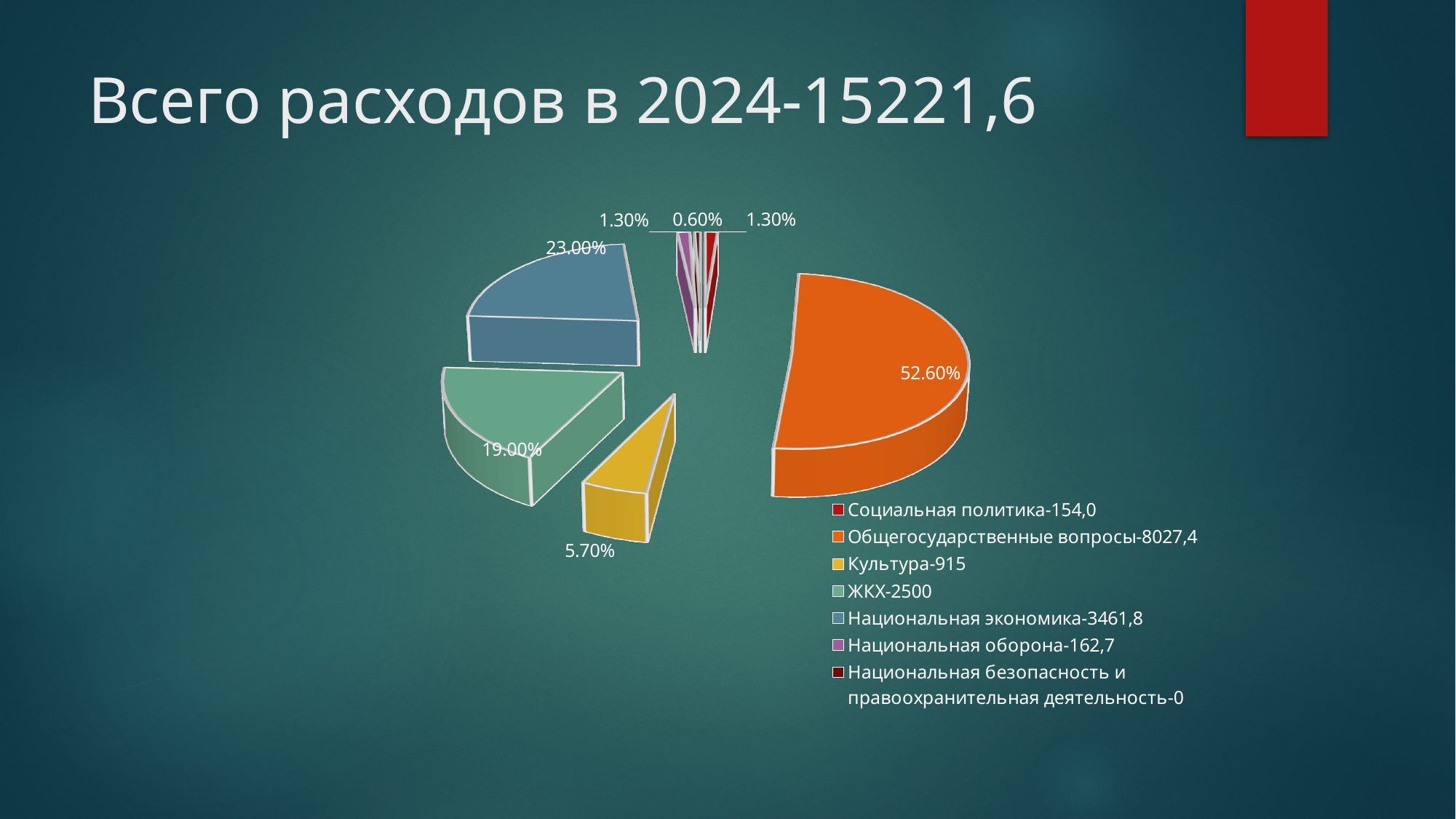
How many categories does the legend list? 7 What is the title of the slide? Всего расходов в 2024-15221,6 Which slice is larger, Национальная экономика or ЖКХ? Национальная экономика What value is given for Национальная экономика in the legend? 3461,8 What value is given for Культура in the legend? 915 What share of the pie does the Общегосударственные вопросы slice have? 52.60% What share of the pie does the Культура slice have? 5.70% What share of the pie does the ЖКХ slice have? 19.00% What is the difference in percentage points between the Национальная экономика slice and the ЖКХ slice? 4.00 What kind of chart is shown on the slide? pie chart Which category has the largest slice of the pie? Общегосударственные вопросы